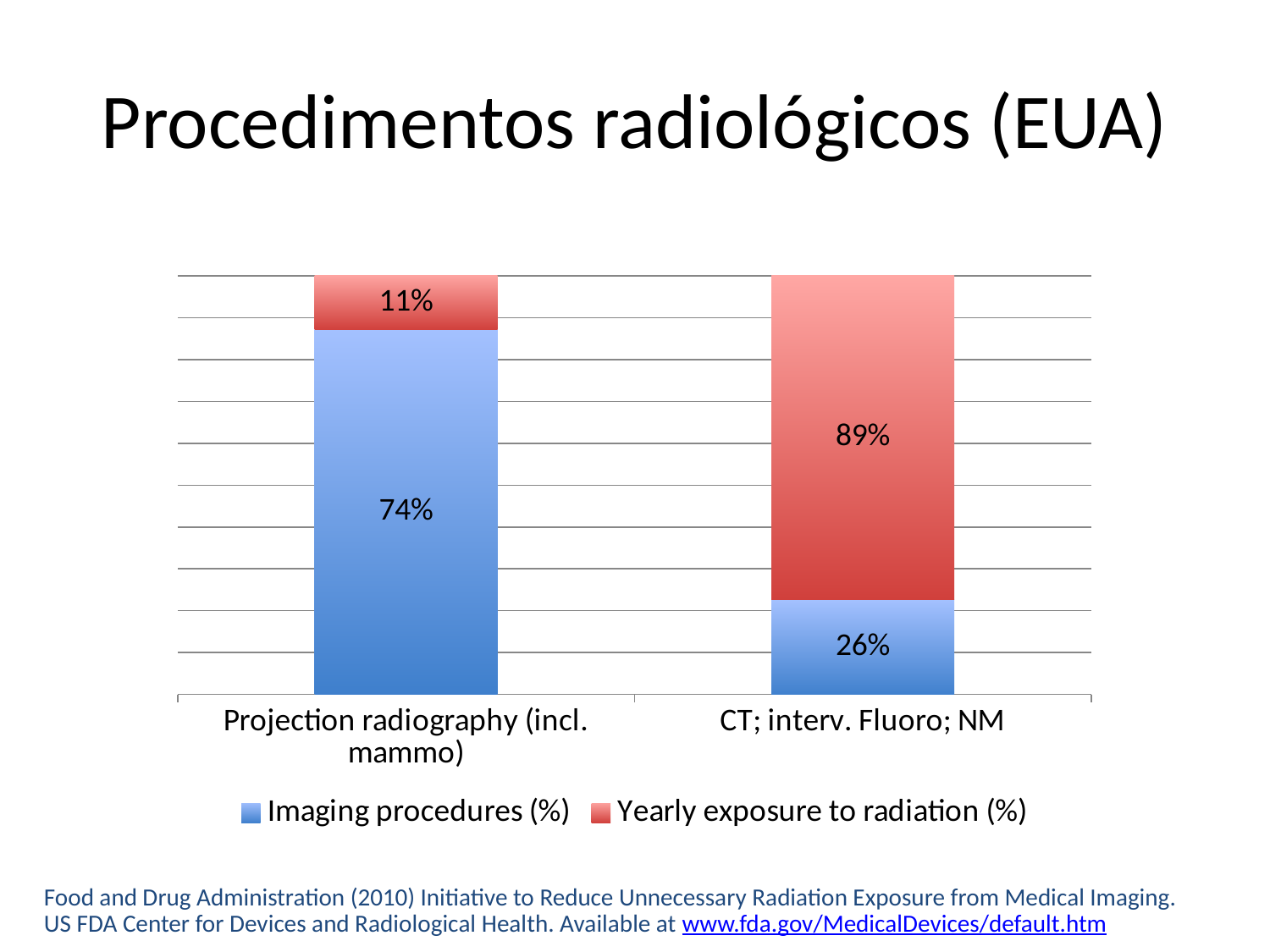
What is the Imaging procedures (%) value for Projection radiography (incl. mammo)? 74% What is the difference between the Imaging procedures (%) values for Projection radiography (incl. mammo) and CT; interv. Fluoro; NM? 48% What is the Yearly exposure to radiation (%) value for Projection radiography (incl. mammo)? 11% How many series does the chart legend list? 2 What kind of chart is shown on the slide? Stacked bar chart For CT; interv. Fluoro; NM, which is larger: Imaging procedures (%) or Yearly exposure to radiation (%)? Yearly exposure to radiation (%) Which category has the lower Imaging procedures (%) value? CT; interv. Fluoro; NM What is the Yearly exposure to radiation (%) value for CT; interv. Fluoro; NM? 89% How many categories are shown on the x axis of the chart? 2 What is the difference between the Yearly exposure to radiation (%) values for CT; interv. Fluoro; NM and Projection radiography (incl. mammo)? 78% Which category has the higher Yearly exposure to radiation (%) value? CT; interv. Fluoro; NM What is the Imaging procedures (%) value for CT; interv. Fluoro; NM? 26%